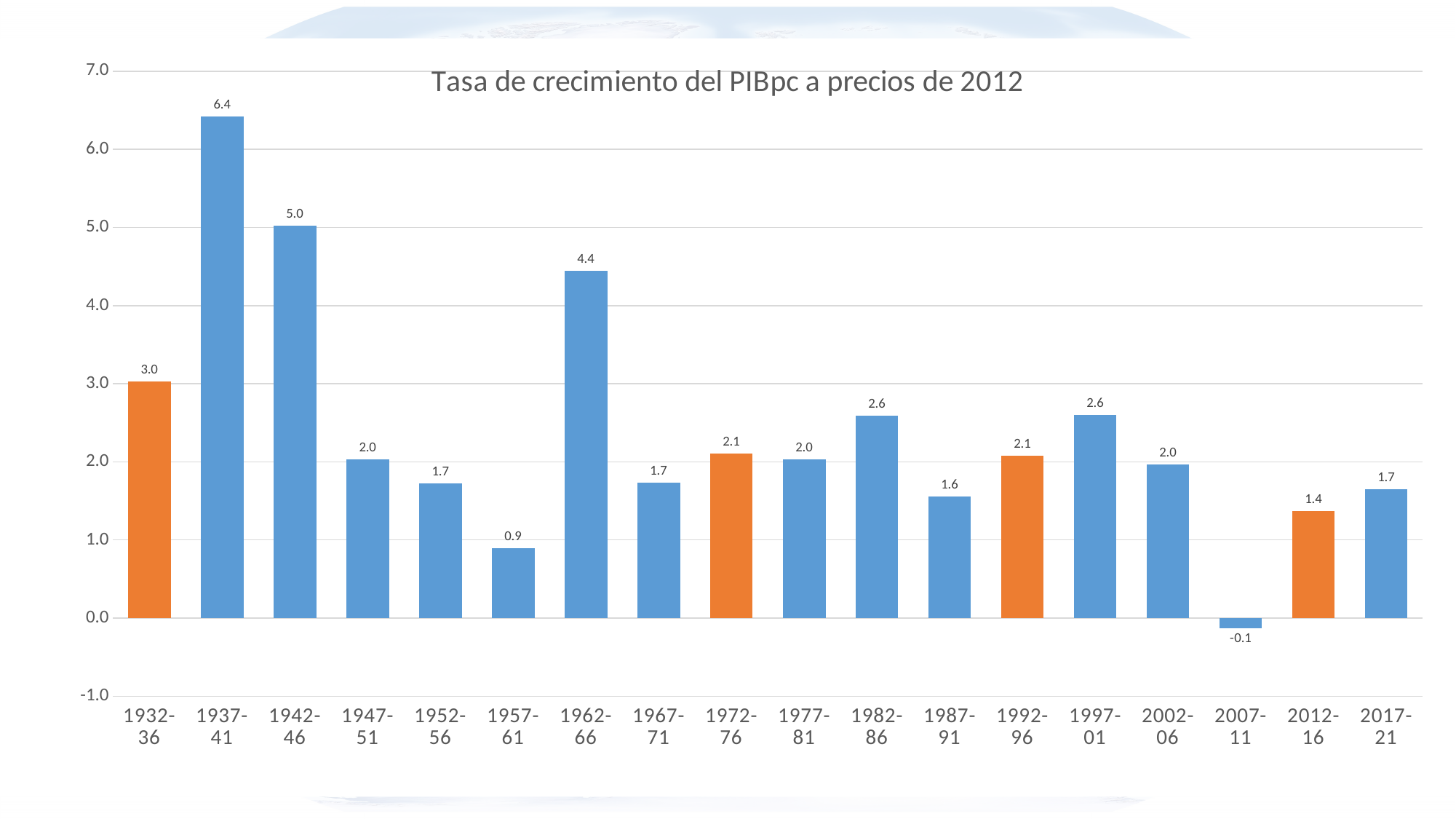
What is the value for 1937-41? 6.4 Which period has the lowest value? 2007-11 What is the difference between the values for 1937-41 and 1942-46? 1.4 Which is larger, the value for 1957-61 or the value for 2012-16? 2012-16 What kind of chart is this? bar chart What is the value for 1962-66? 4.4 Is the value for 1932-36 greater or less than 2.0? greater What is the value for 2007-11? -0.1 Which period has the highest value? 1937-41 What is the title of the chart? Tasa de crecimiento del PIBpc a precios de 2012 How many bars are coloured orange? 4 How many periods are shown on the x axis? 18